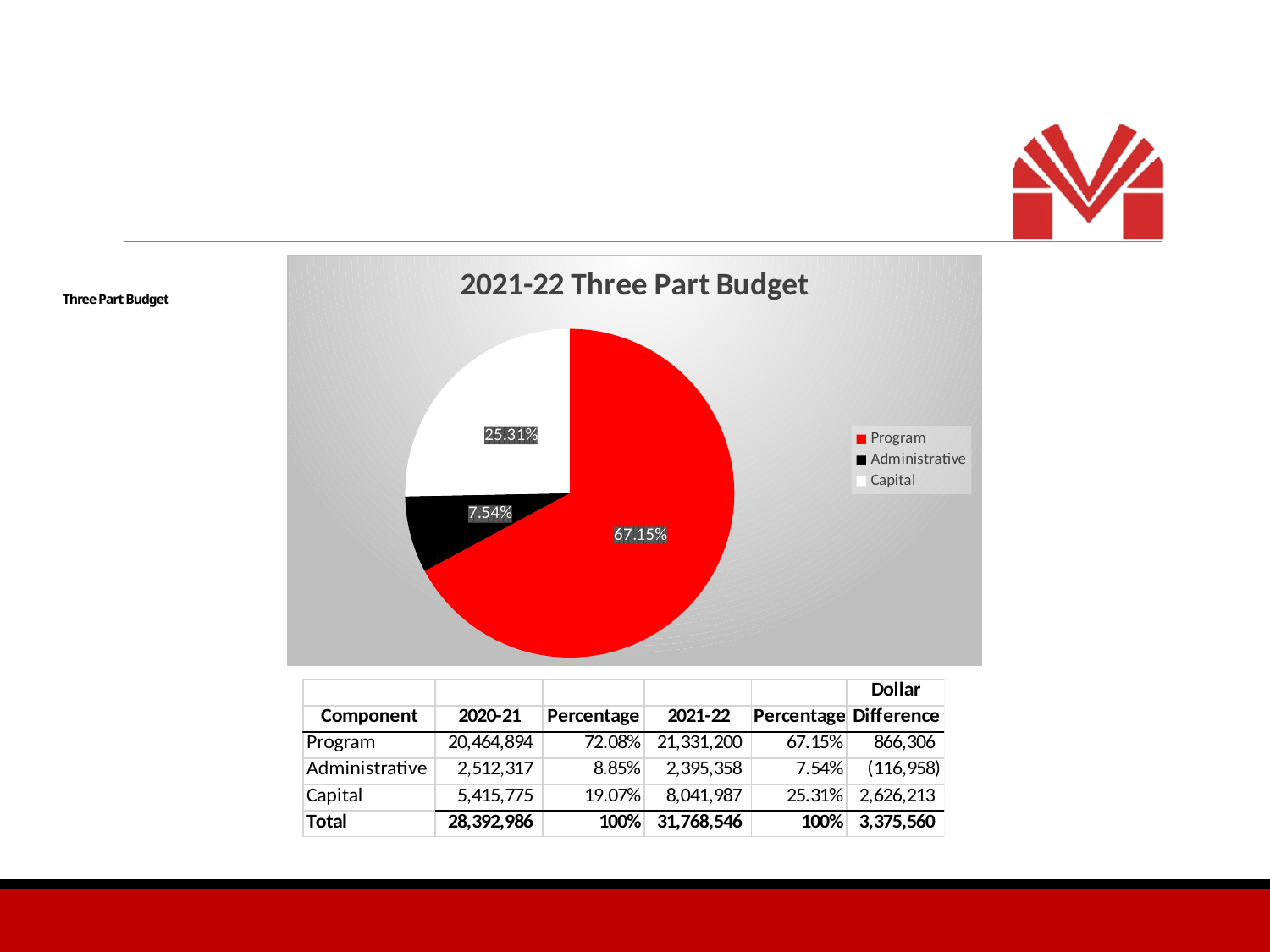
What is the title of the chart? 2021-22 Three Part Budget What colour is the Program slice in the pie chart? red What share of the pie does Capital represent? 25.31% What is the difference in percentage points between the Program slice and the Capital slice? 41.84 Which component has the largest slice of the pie? Program Which slice is larger, Capital or Administrative? Capital How many slices does the pie chart have? 3 What share of the pie does Program represent? 67.15% What share of the pie does Administrative represent? 7.54% Which component has the smallest slice of the pie? Administrative What type of chart is shown on the slide? pie chart How many entries does the legend list? 3